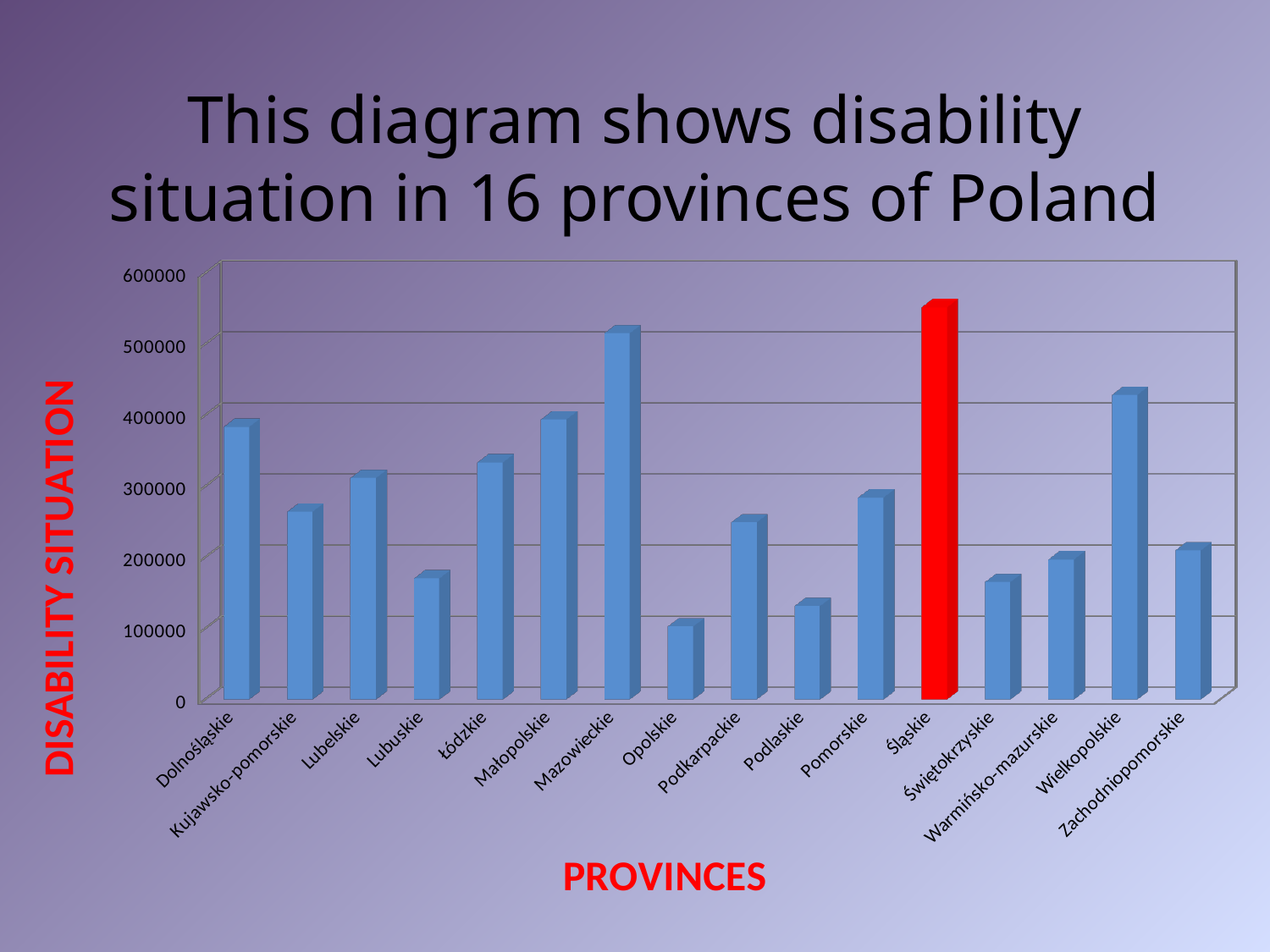
Which province has the lowest value on the chart? Opolskie Is the value for Śląskie greater or less than 500000? greater Which has the larger value, Mazowieckie or Wielkopolskie? Mazowieckie How many provinces are plotted on the chart? 16 Is the value for Kujawsko-pomorskie greater or less than 300000? less What is the title of the vertical axis? DISABILITY SITUATION Is the value for Lubuskie greater or less than 200000? less Which province's bar is coloured red? Śląskie Which province has the highest value on the chart? Śląskie What kind of chart is shown on the slide? bar chart